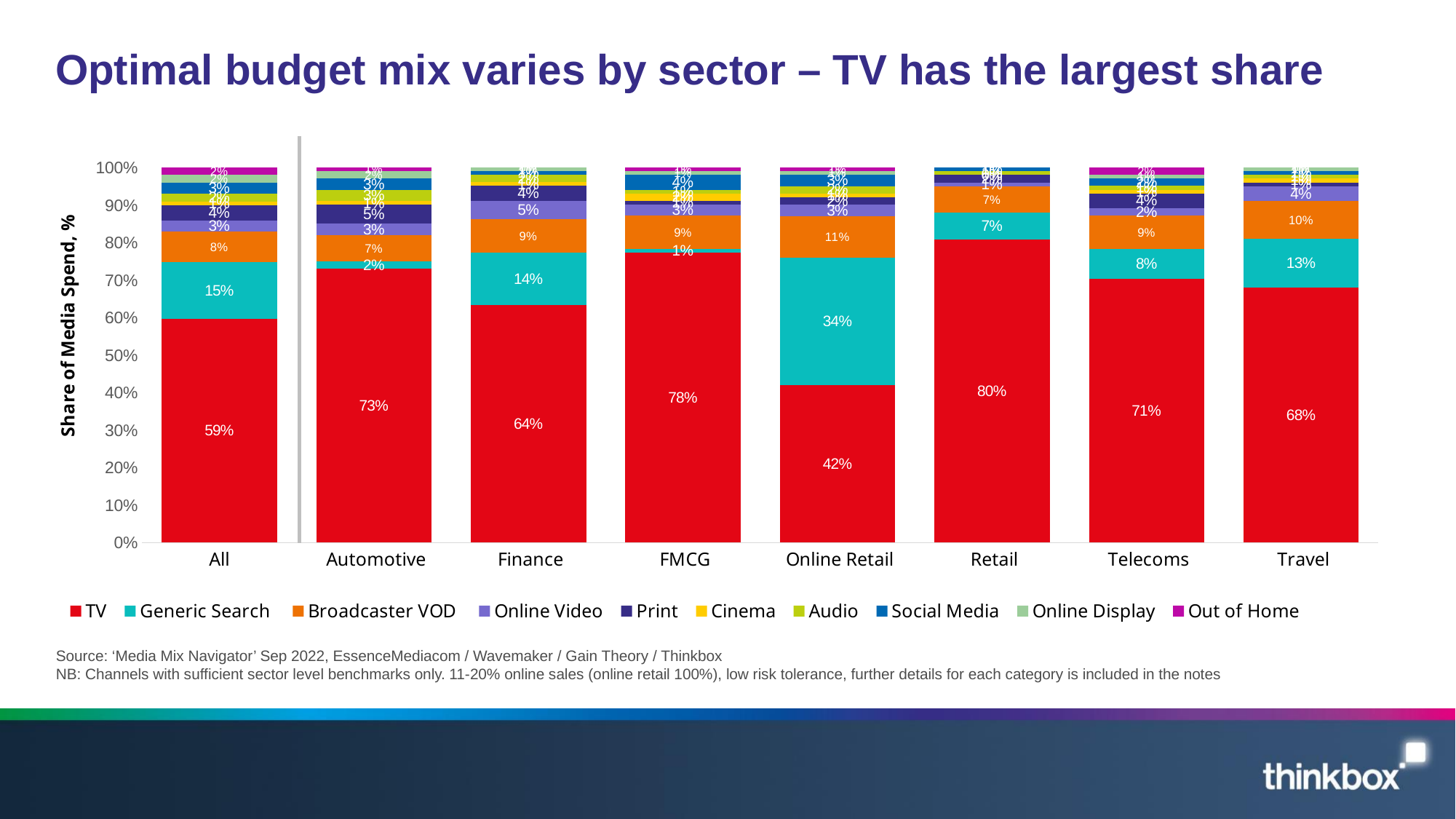
What is the Broadcaster VOD share of media spend for Travel? 10% What is the Generic Search share of media spend for Online Retail? 34% Which sector has the highest TV share of media spend? Retail How many sectors (categories) are shown on the x axis? 8 Which has a larger Generic Search share: Finance or Telecoms? Finance What is the TV share of media spend for Retail? 80% Is the TV share for Automotive greater or less than 70%? greater What is the difference between the TV share for FMCG and the TV share for Finance? 14% Which colour represents TV in the chart? Red Which sector has the lowest TV share of media spend? Online Retail How many series does the legend list? 10 What kind of chart is shown on the slide? Stacked bar chart